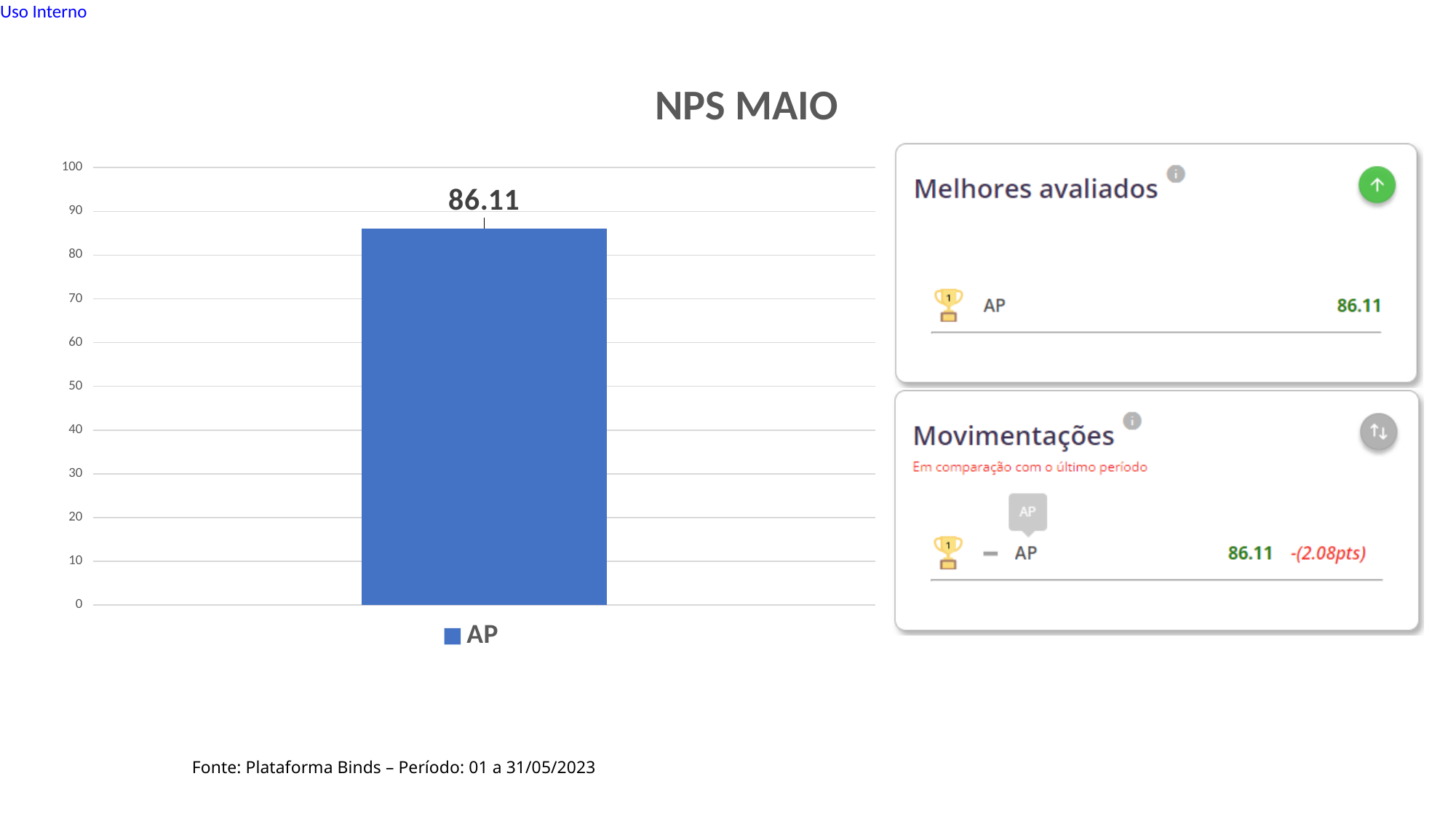
Is the value for AP greater or less than 80? greater What kind of chart is shown on the slide? bar chart What series name appears in the chart legend? AP How many bars are plotted in the NPS MAIO chart? 1 What is the maximum value shown on the vertical axis of the NPS MAIO chart? 100 Is the value for AP greater or less than 90? less How many series does the legend of the NPS MAIO chart list? 1 What is the title of the chart? NPS MAIO What is the value of the AP bar in the NPS MAIO chart? 86.11